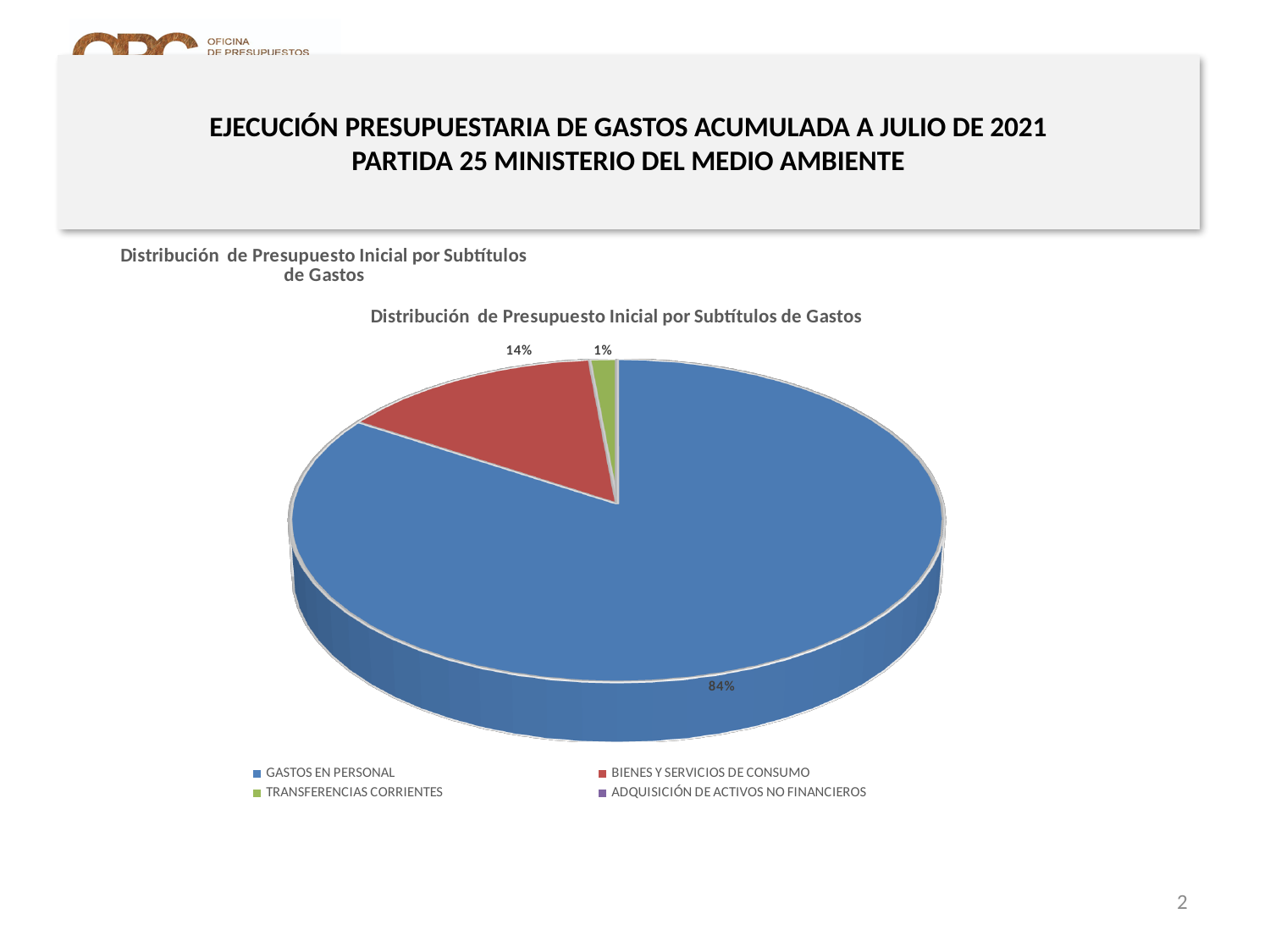
What percentage of the pie does GASTOS EN PERSONAL represent? 84% What is the difference in percentage points between GASTOS EN PERSONAL and BIENES Y SERVICIOS DE CONSUMO? 70 percentage points Which category has the largest slice of the pie? GASTOS EN PERSONAL What percentage is shown for BIENES Y SERVICIOS DE CONSUMO? 14% How many categories does the legend list? 4 Which is larger, the slice for GASTOS EN PERSONAL or the slice for BIENES Y SERVICIOS DE CONSUMO? GASTOS EN PERSONAL What type of chart is shown on the slide? Pie chart What is the title of the chart? Distribución de Presupuesto Inicial por Subtítulos de Gastos Which is larger, the slice for BIENES Y SERVICIOS DE CONSUMO or the slice for TRANSFERENCIAS CORRIENTES? BIENES Y SERVICIOS DE CONSUMO What percentage is shown for TRANSFERENCIAS CORRIENTES? 1% What colour is the slice for GASTOS EN PERSONAL? Blue